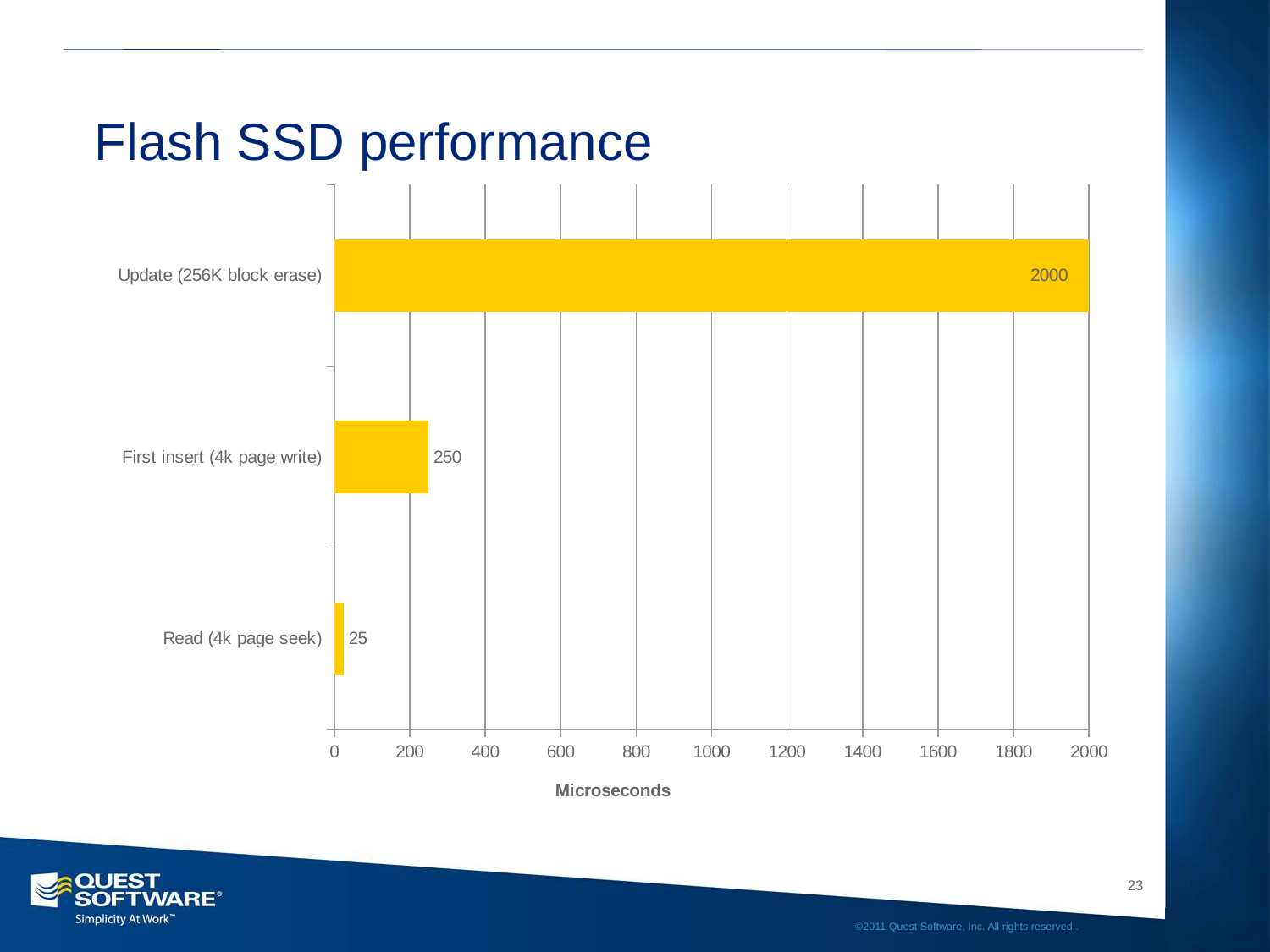
What kind of chart is shown on the slide? bar chart Which category has the highest value? Update (256K block erase) What is the value for Update (256K block erase)? 2000 What is the label of the horizontal axis? Microseconds What is the value for First insert (4k page write)? 250 Which category has the lowest value? Read (4k page seek) What is the difference between the values for First insert (4k page write) and Read (4k page seek)? 225 What is the difference between the values for Update (256K block erase) and First insert (4k page write)? 1750 How many categories are shown in the chart? 3 Is the value for First insert (4k page write) greater or less than 400? less What is the value for Read (4k page seek)? 25 Which is larger, the value for First insert (4k page write) or the value for Read (4k page seek)? First insert (4k page write)